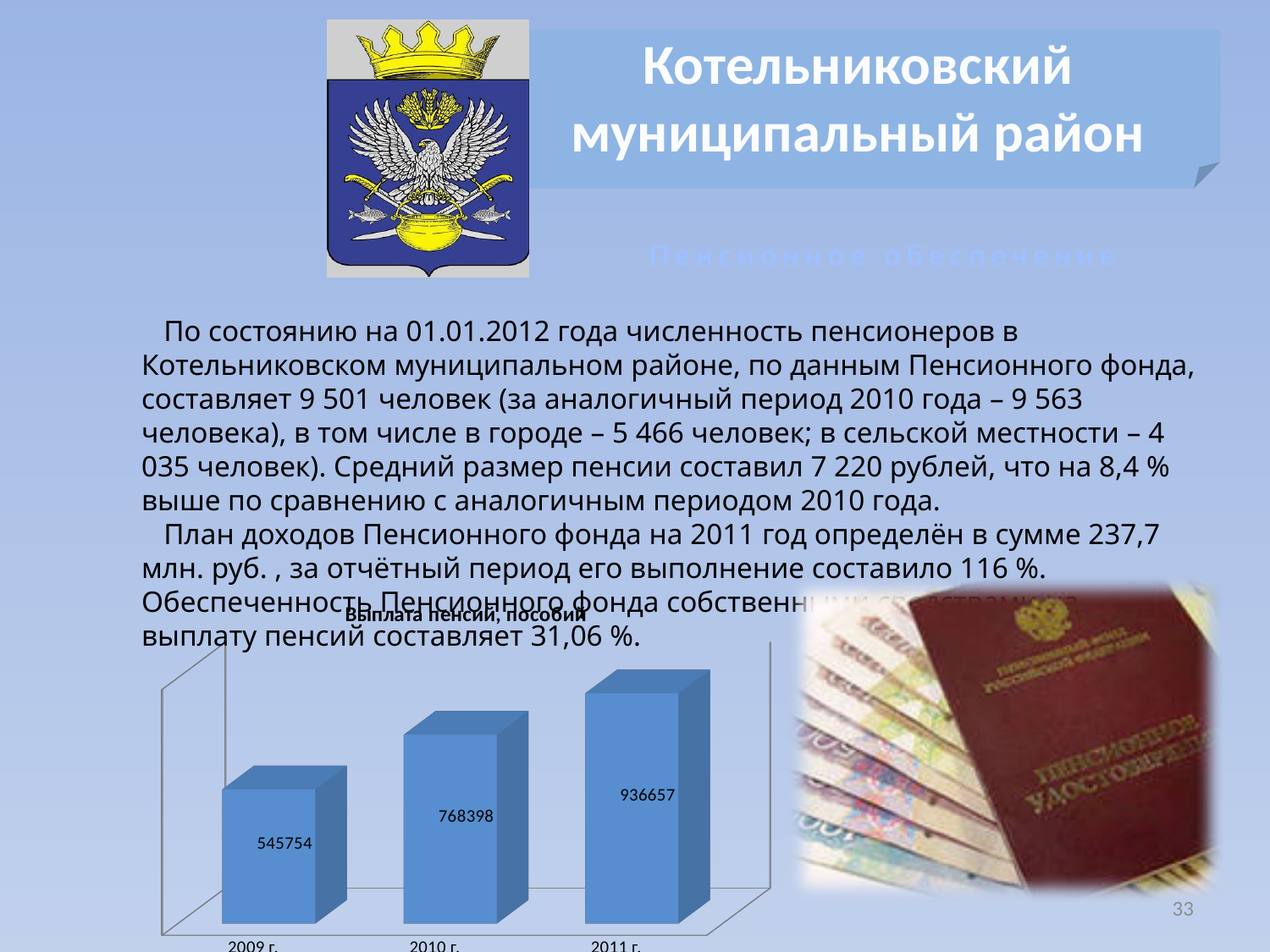
What is the difference between the values for 2011 г. and 2010 г.? 168259 What is the value for 2010 г. in the chart? 768398 What kind of chart is shown on the slide? bar chart Which is larger, the value for 2009 г. or the value for 2011 г.? 2011 г. Which year has the highest value in the chart? 2011 г. What is the value for 2011 г. in the chart? 936657 Which year has the lowest value in the chart? 2009 г. What is the title of the chart? Выплата пенсий, пособий What is the difference between the values for 2010 г. and 2009 г.? 222644 Do the values rise or fall from 2009 г. to 2011 г.? rise What is the value for 2009 г. in the chart? 545754 How many bars are shown in the chart? 3